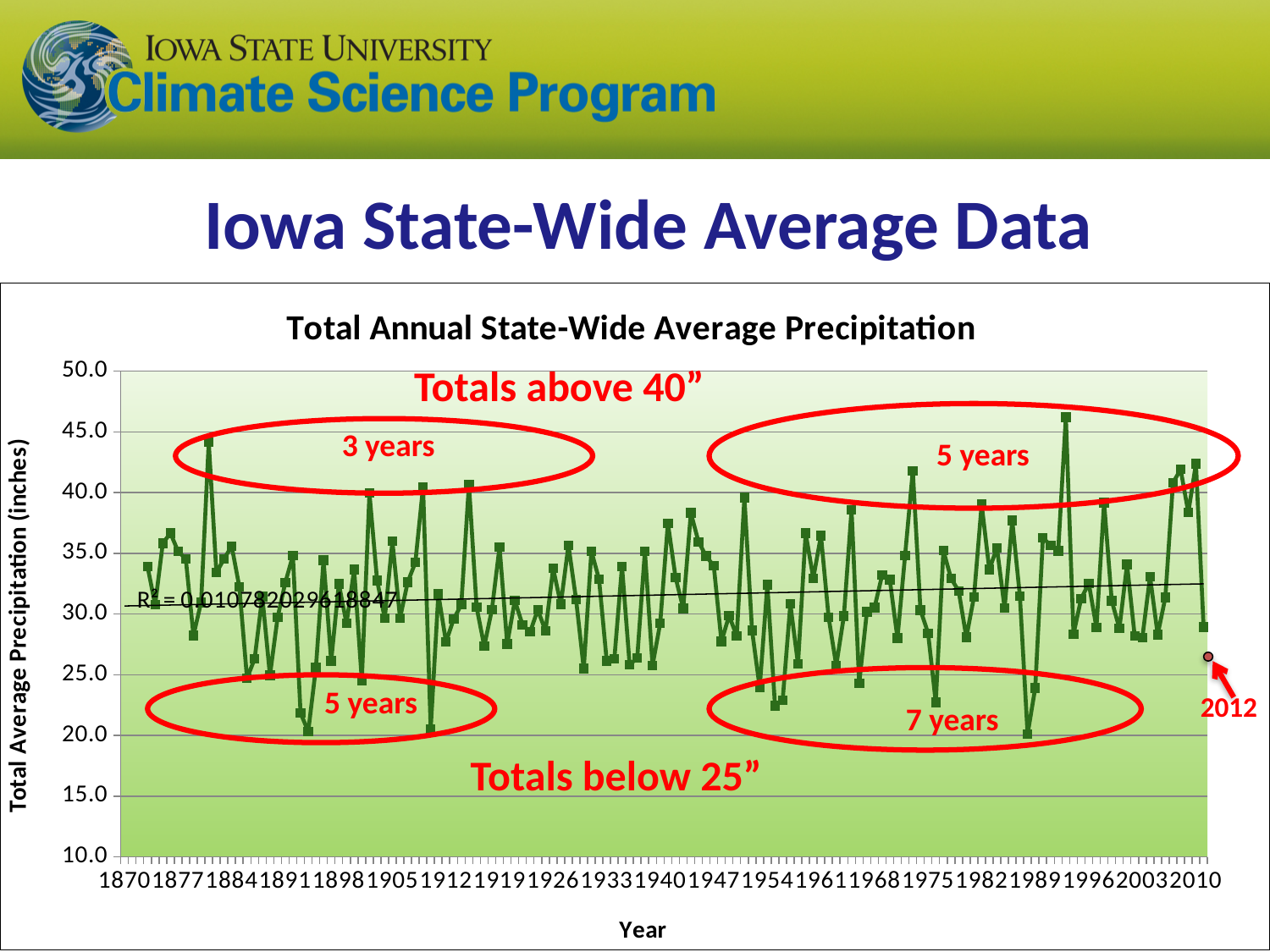
Is the value for 1988 greater or less than 25? less Is the value for 2012 greater or less than 25? greater Is the value for 2012 greater or less than 30? less Does the linear trend line across the chart rise or fall from 1870 to 2010? rises slightly What kind of chart is shown on the slide? line chart According to the annotation, how many years in the left-hand circled group had totals above 40 inches? 3 years What is the label on the vertical axis of the chart? Total Average Precipitation (inches) According to the annotation, how many years in the right-hand circled group had totals below 25 inches? 7 years What is the title of the chart? Total Annual State-Wide Average Precipitation According to the annotation, how many years in the right-hand circled group had totals above 40 inches? 5 years